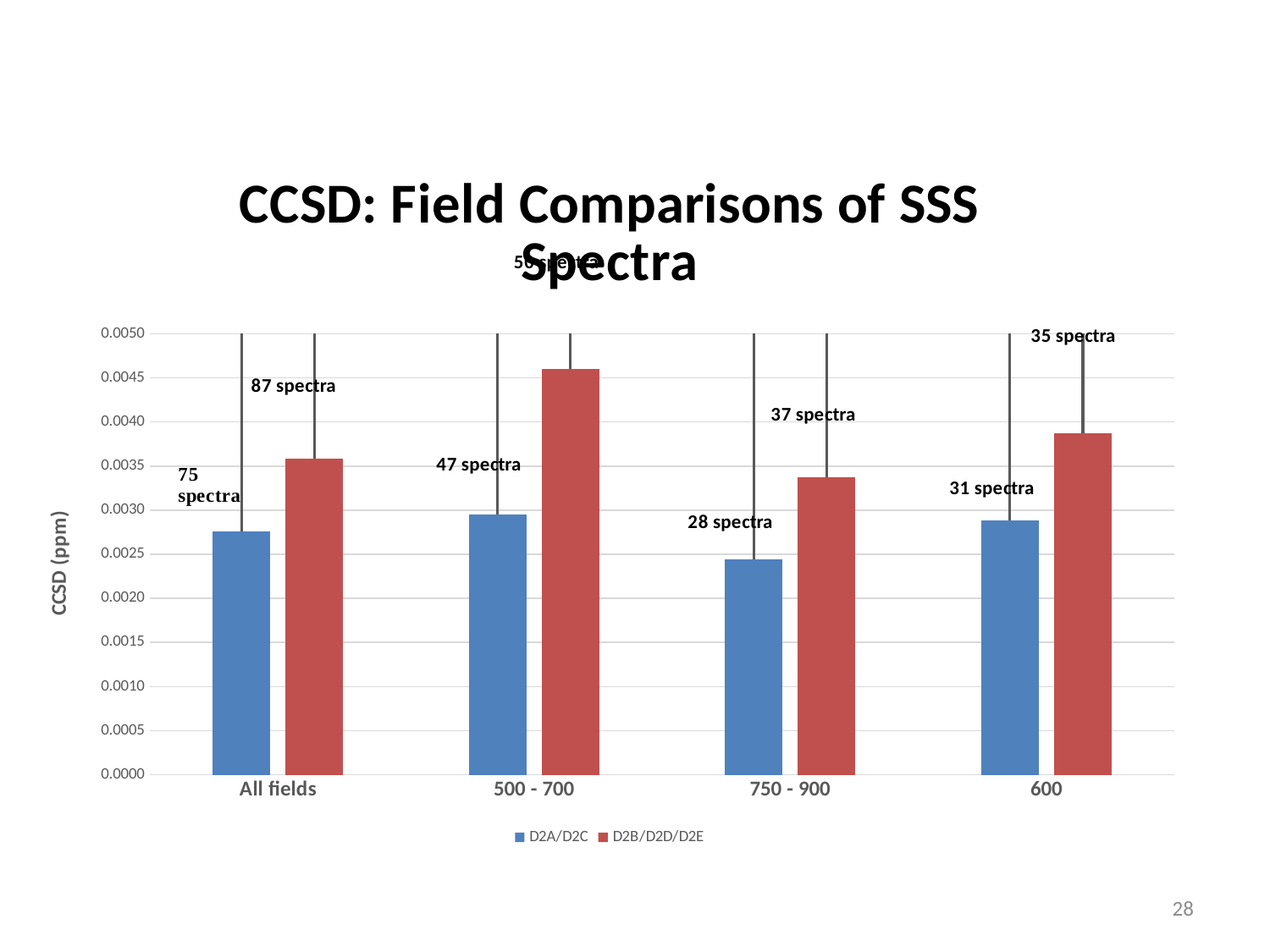
Is the D2A/D2C value for 750 - 900 greater or less than 0.0030? less What is the label on the vertical axis? CCSD (ppm) Is the D2A/D2C value for All fields greater or less than 0.0030? less Which category has the lowest D2A/D2C value? 750 - 900 What kind of chart is shown on the slide? Bar chart Is the D2B/D2D/D2E value for 500 - 700 greater or less than 0.0040? greater How many spectra are annotated for the D2A/D2C bar in the 500 - 700 category? 47 spectra How many categories are shown on the x axis? 4 Which category has the highest D2B/D2D/D2E value? 500 - 700 In the 500 - 700 category, which series has the larger value, D2A/D2C or D2B/D2D/D2E? D2B/D2D/D2E How many series does the legend list? 2